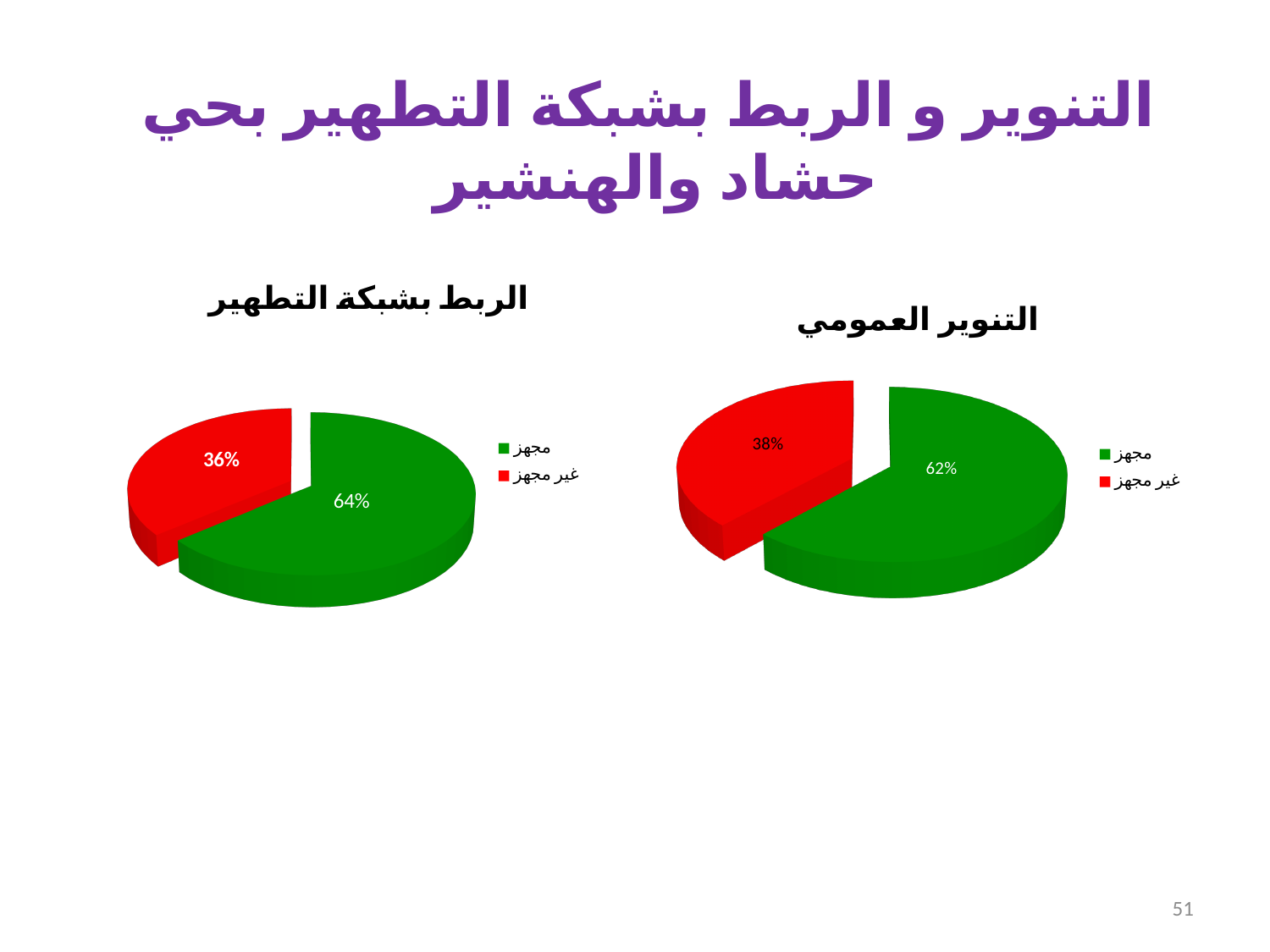
In the chart titled "التنوير العمومي" (right), what percentage is shown for "غير مجهز"? 38% In the chart titled "الربط بشبكة التطهير" (left), what is the difference in percentage points between "مجهز" and "غير مجهز"? 28 In the chart titled "التنوير العمومي" (right), what is the difference in percentage points between "مجهز" and "غير مجهز"? 24 In the chart titled "الربط بشبكة التطهير" (left), what percentage is shown for "غير مجهز"? 36% In the chart titled "التنوير العمومي" (right), which category has the smallest slice? غير مجهز In the chart titled "التنوير العمومي" (right), what percentage is shown for "مجهز"? 62% In the chart titled "الربط بشبكة التطهير" (left), what percentage is shown for "مجهز"? 64% Which chart shows a larger share for "مجهز": "الربط بشبكة التطهير" (left) or "التنوير العمومي" (right)? الربط بشبكة التطهير What type of chart is the chart titled "التنوير العمومي" (right)? Pie chart In the chart titled "التنوير العمومي" (right), what colour is the "غير مجهز" slice? Red In the chart titled "الربط بشبكة التطهير" (left), which category has the largest slice? مجهز How many slices does the chart titled "الربط بشبكة التطهير" (left) have? 2